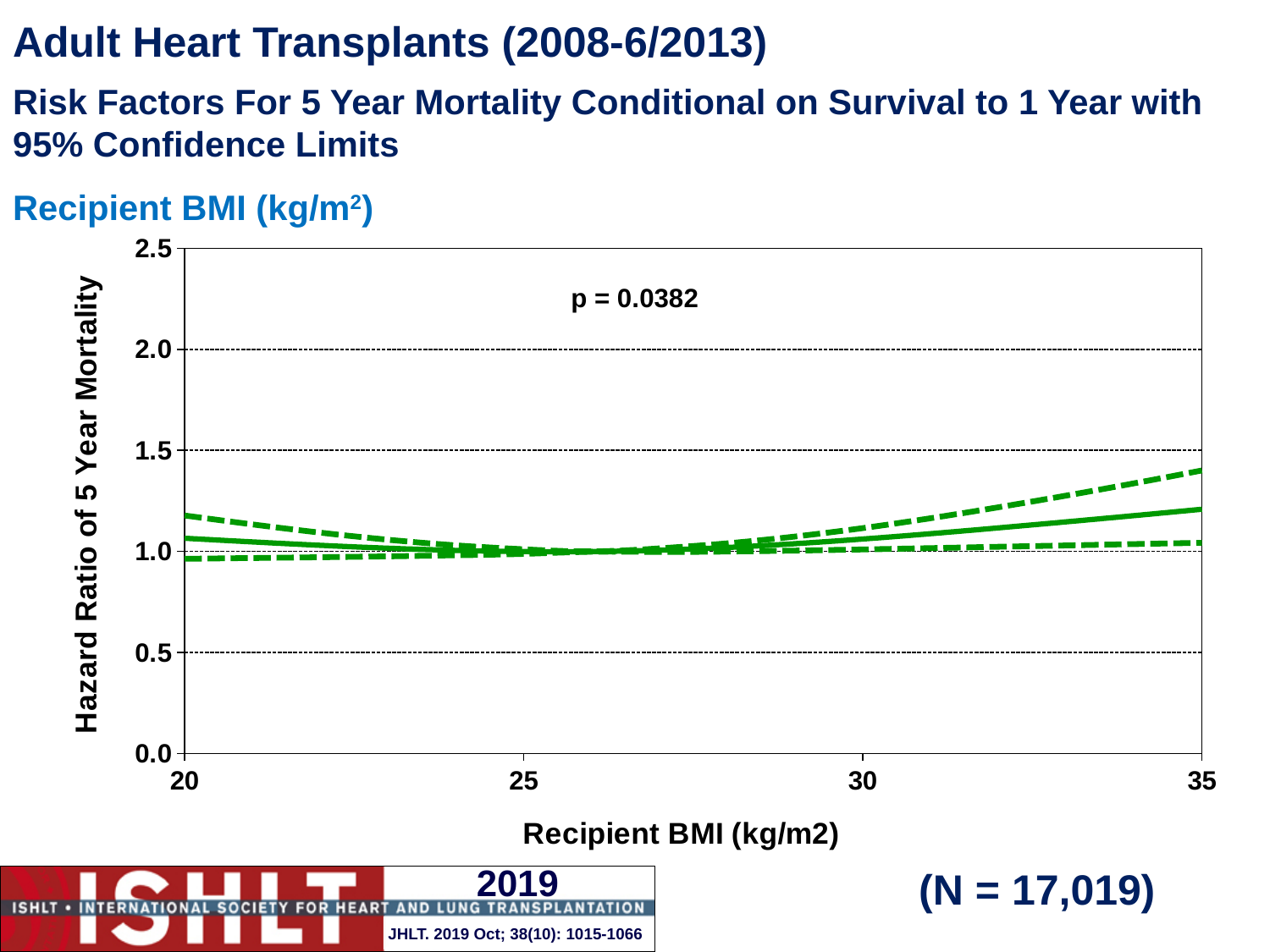
Is the value of the upper dashed line at a recipient BMI of 35 greater or less than 1.5? less What kind of chart is shown on the slide? line chart What p-value is printed on the chart? p = 0.0382 Is the value of the solid line at a recipient BMI of 35 greater or less than 1.5? less Is the value of the upper dashed line at a recipient BMI of 20 greater or less than 1.0? greater What sample size (N) is shown on the slide? N = 17,019 How many lines are plotted on the chart? 3 At which recipient BMI value shown on the x axis does the solid line reach its highest hazard ratio? 35 What is the highest value shown on the y axis? 2.5 Does the solid line rise or fall as recipient BMI increases from 25 to 35? rise